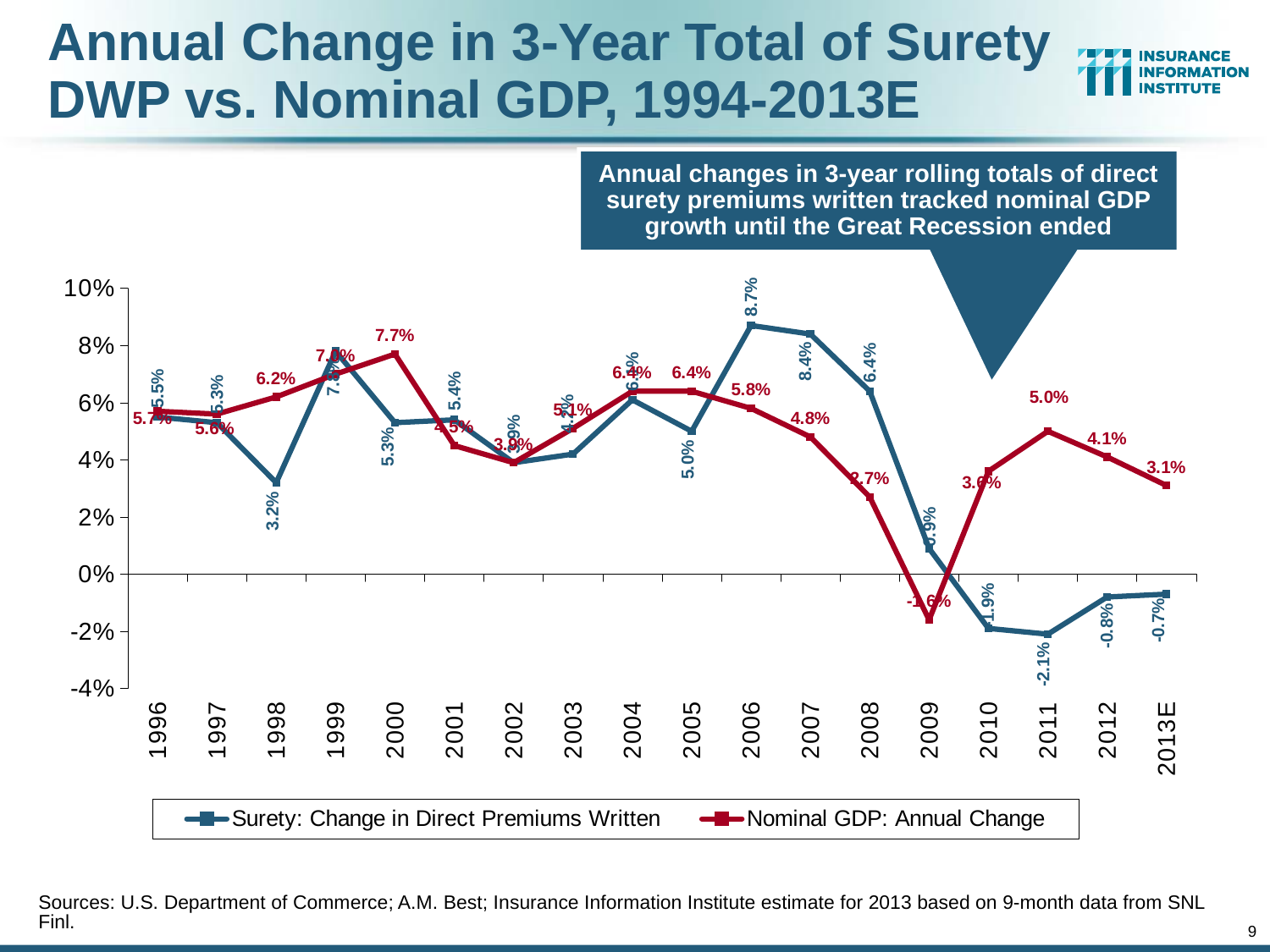
How many years are plotted along the x axis? 18 In 2011, which series has the larger value, Surety or Nominal GDP? Nominal GDP: Annual Change What is the difference between the Surety value and the Nominal GDP value in 2006? 2.9 percentage points What is the Surety: Change in Direct Premiums Written value for 2013E? -0.7% Does the Surety: Change in Direct Premiums Written series rise or fall from 2006 to 2011? Fall What is the Surety: Change in Direct Premiums Written value for 2006? 8.7% In which year does the Nominal GDP: Annual Change series reach its highest value? 2000 What type of chart is shown on the slide? Line chart What is the Nominal GDP: Annual Change value for 2000? 7.7% In which year does the Surety: Change in Direct Premiums Written series reach its highest value? 2006 In which year does the Surety: Change in Direct Premiums Written series reach its lowest value? 2011 How many series does the legend list? 2